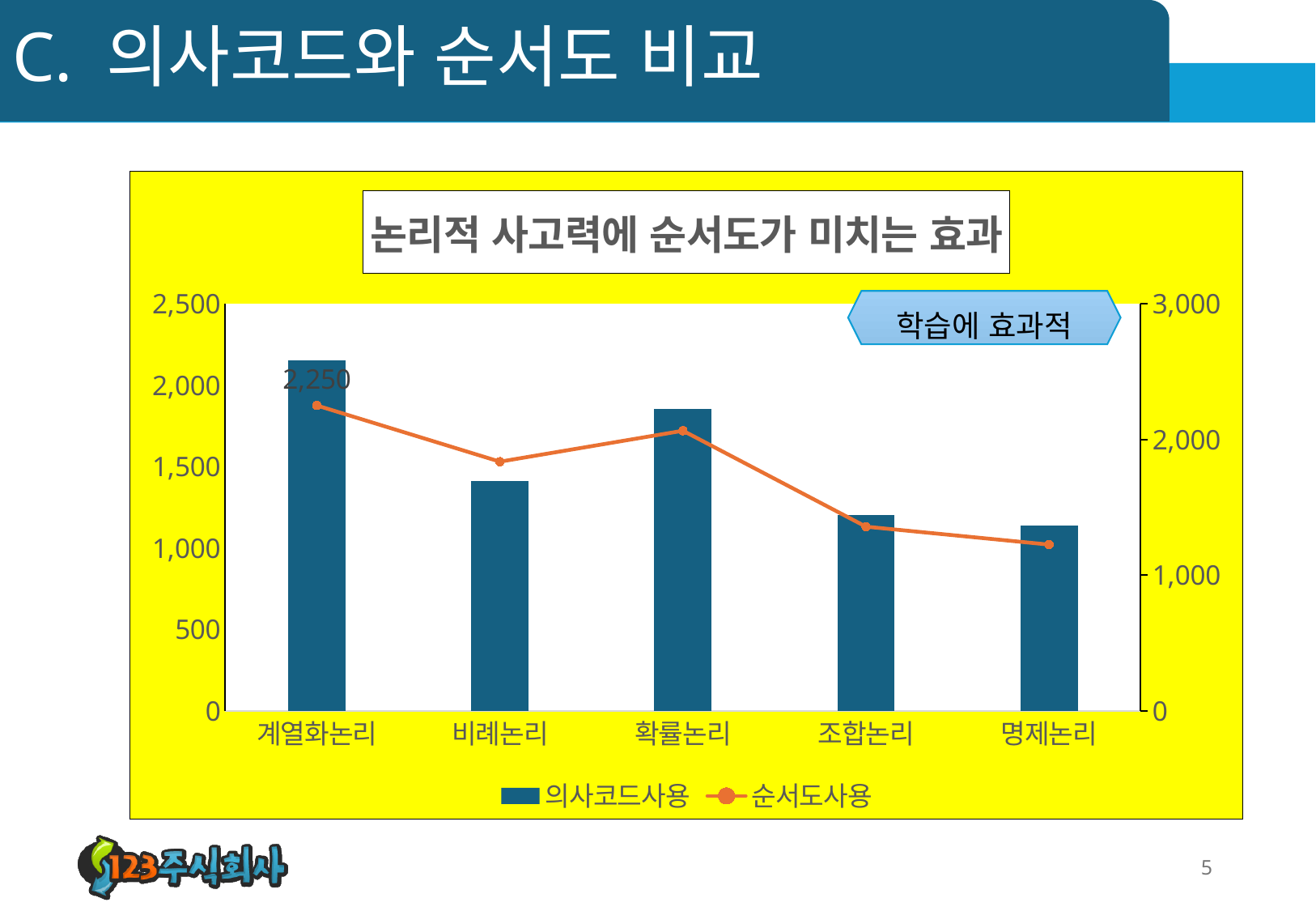
Which category has the lowest 순서도사용 value? 명제논리 What is the title of the chart? 논리적 사고력에 순서도가 미치는 효과 Is the 의사코드사용 value for 조합논리 greater or less than 1,000? greater Which category has the highest 의사코드사용 bar? 계열화논리 How many series does the legend list? 2 What kind of chart is shown on the slide? A combined bar and line chart Is the 의사코드사용 value for 확률논리 greater or less than 1,500? greater From 확률논리 to 명제논리, does the 순서도사용 line rise or fall? fall What is the value of 순서도사용 for 계열화논리? 2,250 Which has the larger 의사코드사용 value, 확률논리 or 비례논리? 확률논리 How many categories are shown on the x axis? 5 Is the 의사코드사용 value for 비례논리 greater or less than 1,500? less